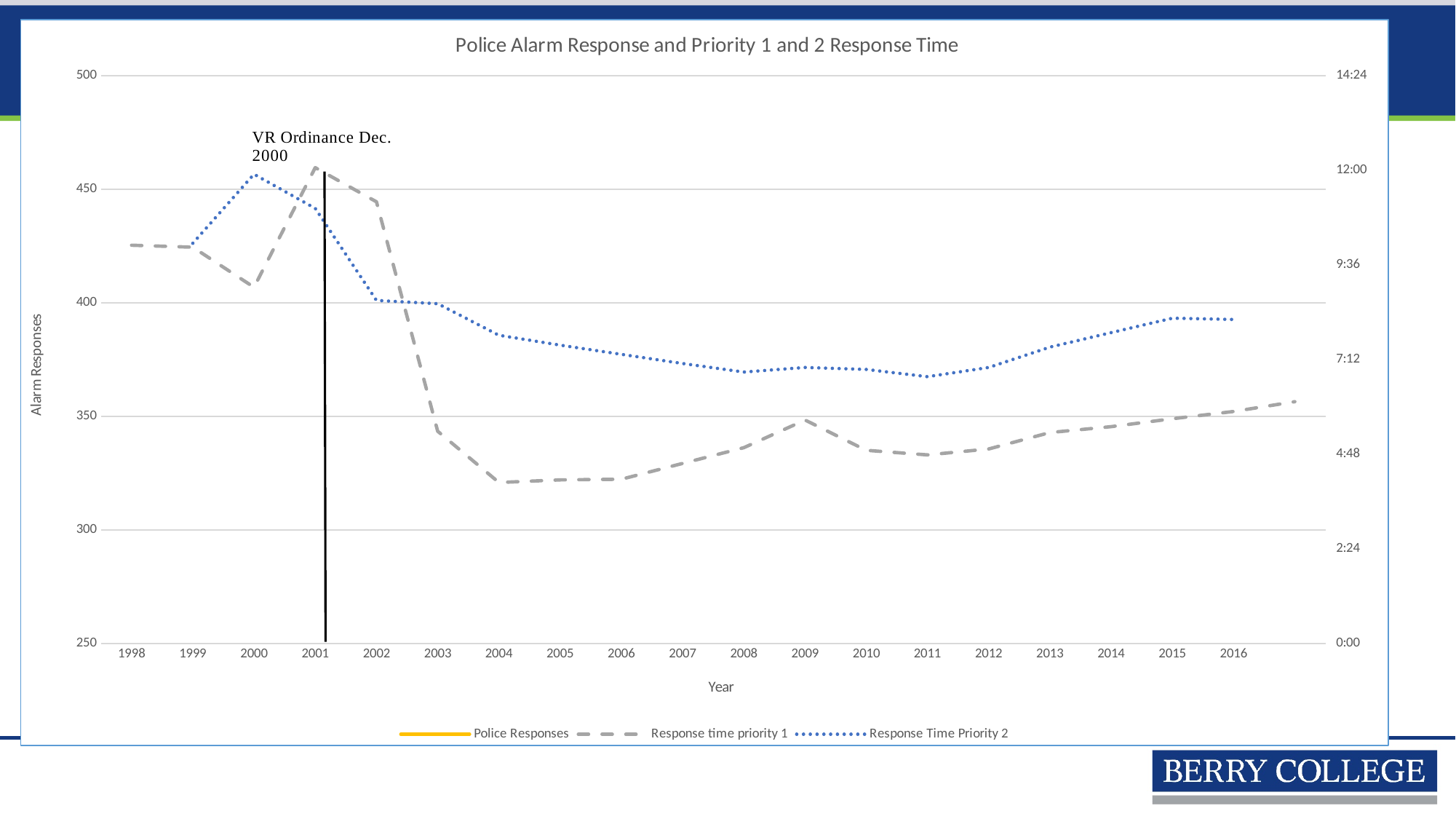
What kind of chart is shown on the slide? Line chart What event does the annotation next to the vertical black line mark? VR Ordinance Dec. 2000 How many series does the legend list? 3 In which year does the Response Time Priority 2 series reach its highest point? 2000 In 2001, which series is higher: Response time priority 1 or Response Time Priority 2? Response time priority 1 In which year does the Response time priority 1 series reach its highest point? 2001 Does the Response Time Priority 2 series rise or fall between 2011 and 2016? Rise How many years are labelled on the x axis? 19 Does the Response time priority 1 series rise or fall between 2001 and 2004? Fall What is the title of the chart? Police Alarm Response and Priority 1 and 2 Response Time In 2004, which series is higher: Response time priority 1 or Response Time Priority 2? Response Time Priority 2 What is the first year shown on the x axis? 1998